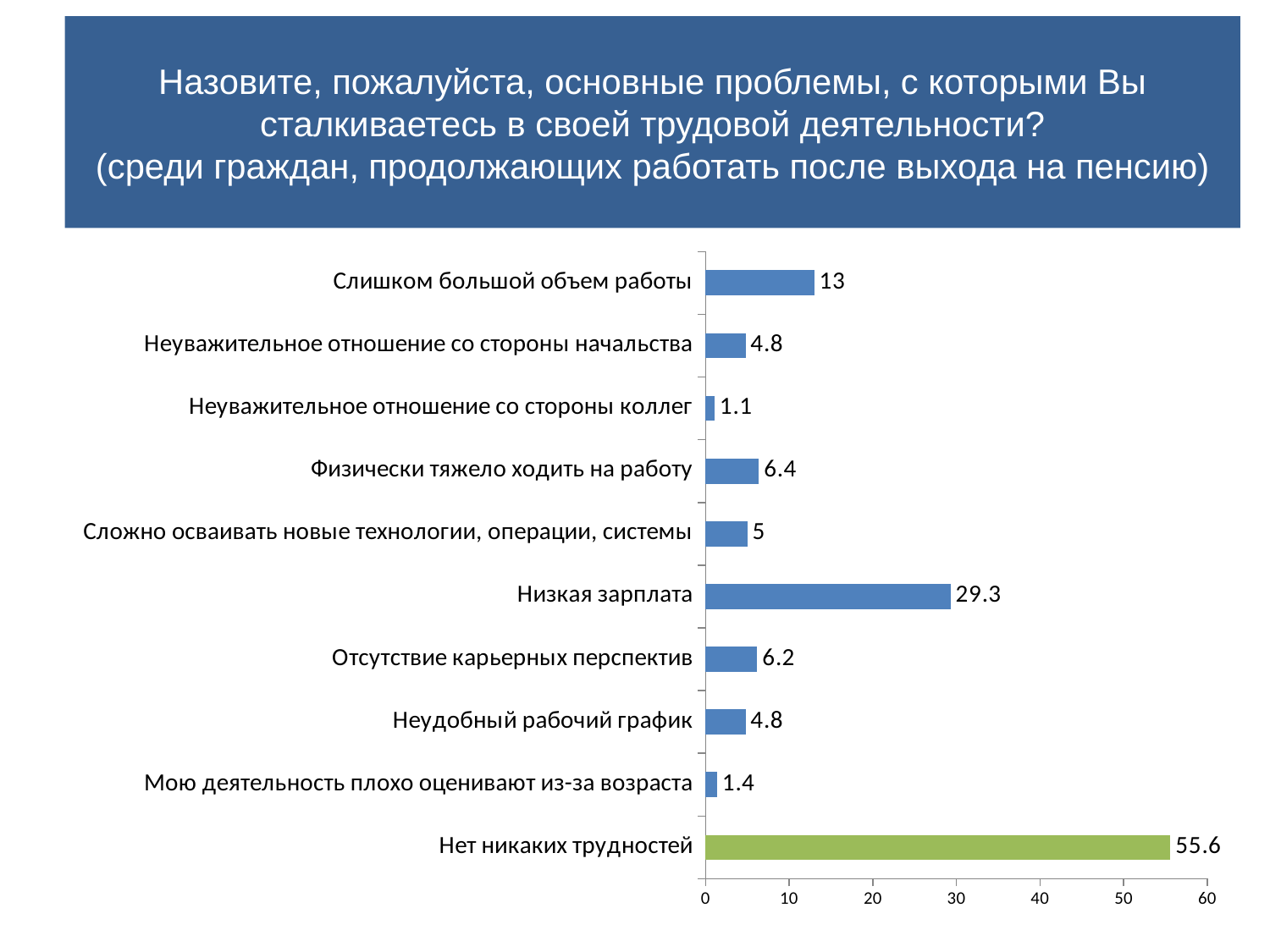
Which is larger: "Отсутствие карьерных перспектив" or "Сложно осваивать новые технологии, операции, системы"? Отсутствие карьерных перспектив Which bar is shown in a different colour (green) from the others? Нет никаких трудностей What kind of chart is shown on the slide? bar chart What is the value for "Мою деятельность плохо оценивают из-за возраста"? 1.4 What is the value for "Слишком большой объем работы"? 13 How many categories are shown in the chart? 10 Which category has the highest value? Нет никаких трудностей What is the value for "Низкая зарплата"? 29.3 What is the difference between "Нет никаких трудностей" and "Низкая зарплата"? 26.3 Which category has the lowest value? Неуважительное отношение со стороны коллег Is the value for "Низкая зарплата" greater or less than 30? less What is the value for "Физически тяжело ходить на работу"? 6.4